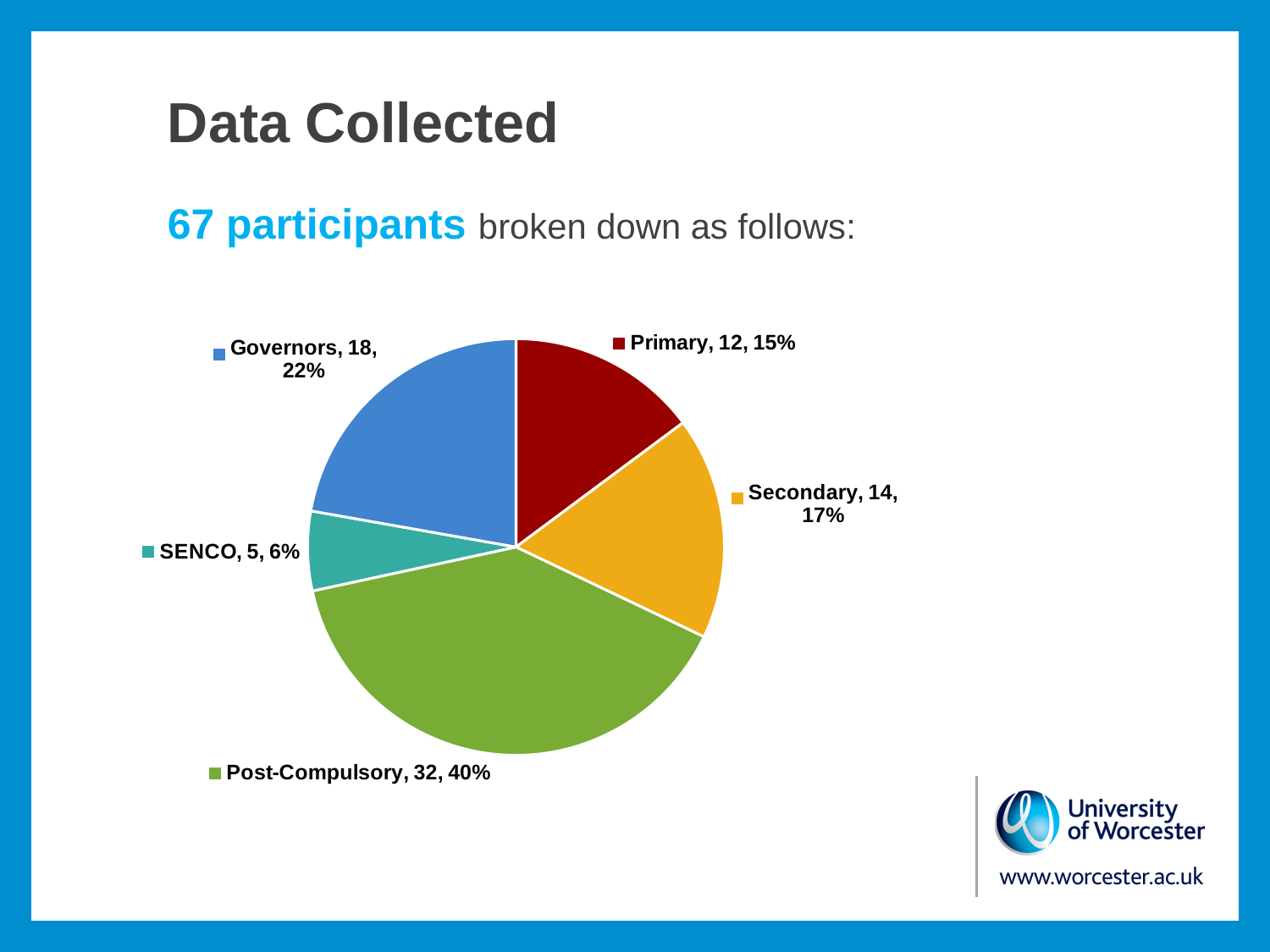
What is the total number of participants across all categories? 67 Which category has the largest number of participants? Post-Compulsory How many categories are shown in the pie chart? 5 What share of the pie does the Primary slice represent? 15% Which has more participants, Primary or Secondary? Secondary What colour is the SENCO slice of the pie chart? teal What is the difference in participants between Post-Compulsory and Governors? 14 Which category has the smallest number of participants? SENCO What kind of chart is shown on the slide? pie chart What percentage of participants are Governors? 22% How many participants are in the Post-Compulsory category? 32 How many participants are in the Secondary category? 14